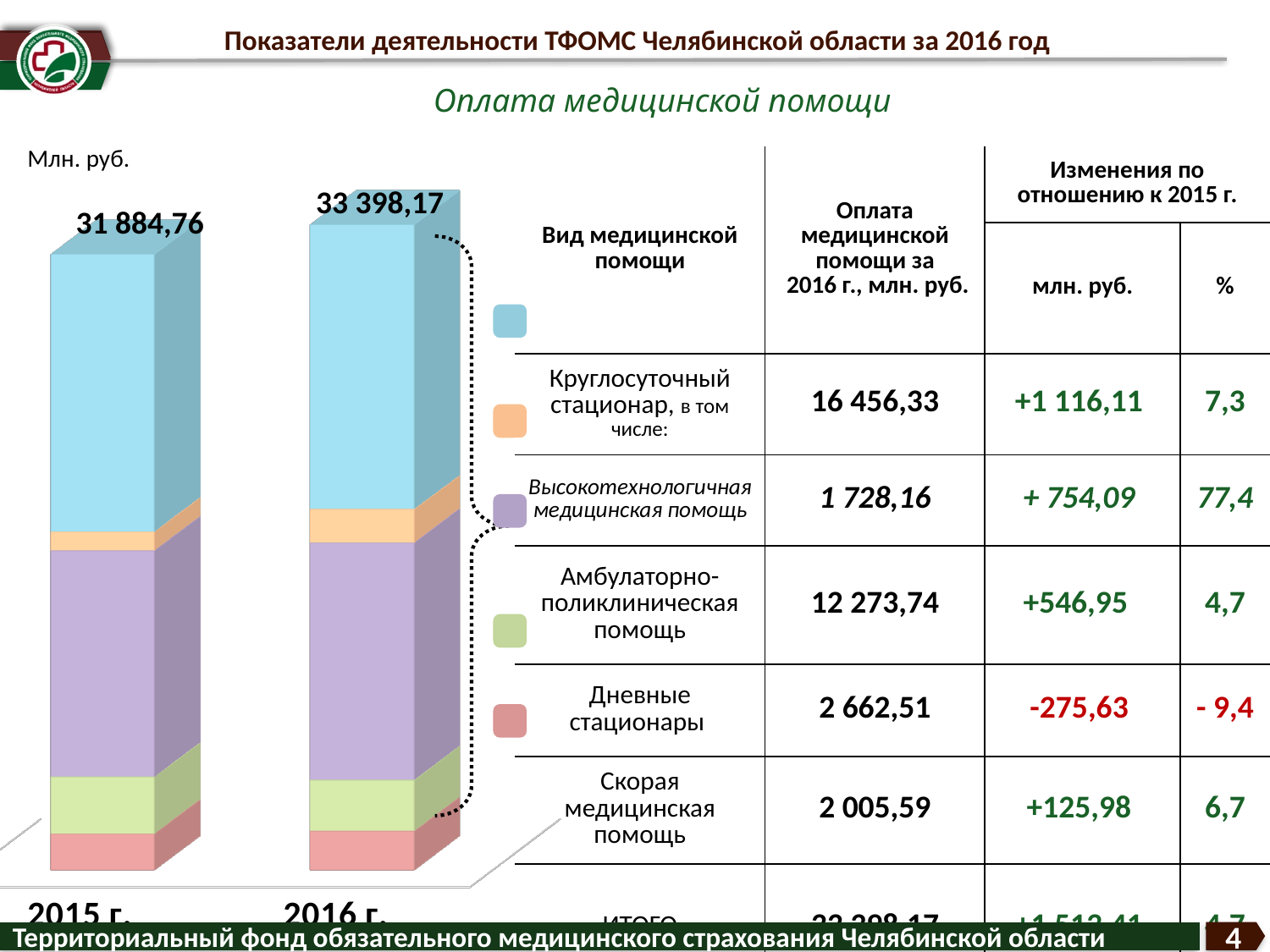
How many coloured segments (series) make up each stacked bar? 5 Which year has the higher total, 2015 г. or 2016 г.? 2016 г. What kind of chart is shown on the slide? Stacked bar chart What is the total value shown for the 2016 г. bar? 33 398,17 What is the title of the chart section on the slide? Оплата медицинской помощи Which segment is the smallest in the 2016 г. bar? Высокотехнологичная медицинская помощь (orange) What is the total value shown for the 2015 г. bar? 31 884,76 How many bars are plotted in the chart? 2 Which segment is the largest in the 2016 г. bar? Круглосуточный стационар (blue) Does the total value rise or fall from 2015 г. to 2016 г.? Rise What unit is indicated for the chart values? Млн. руб. By how much does the 2016 г. total exceed the 2015 г. total? 1 513,41